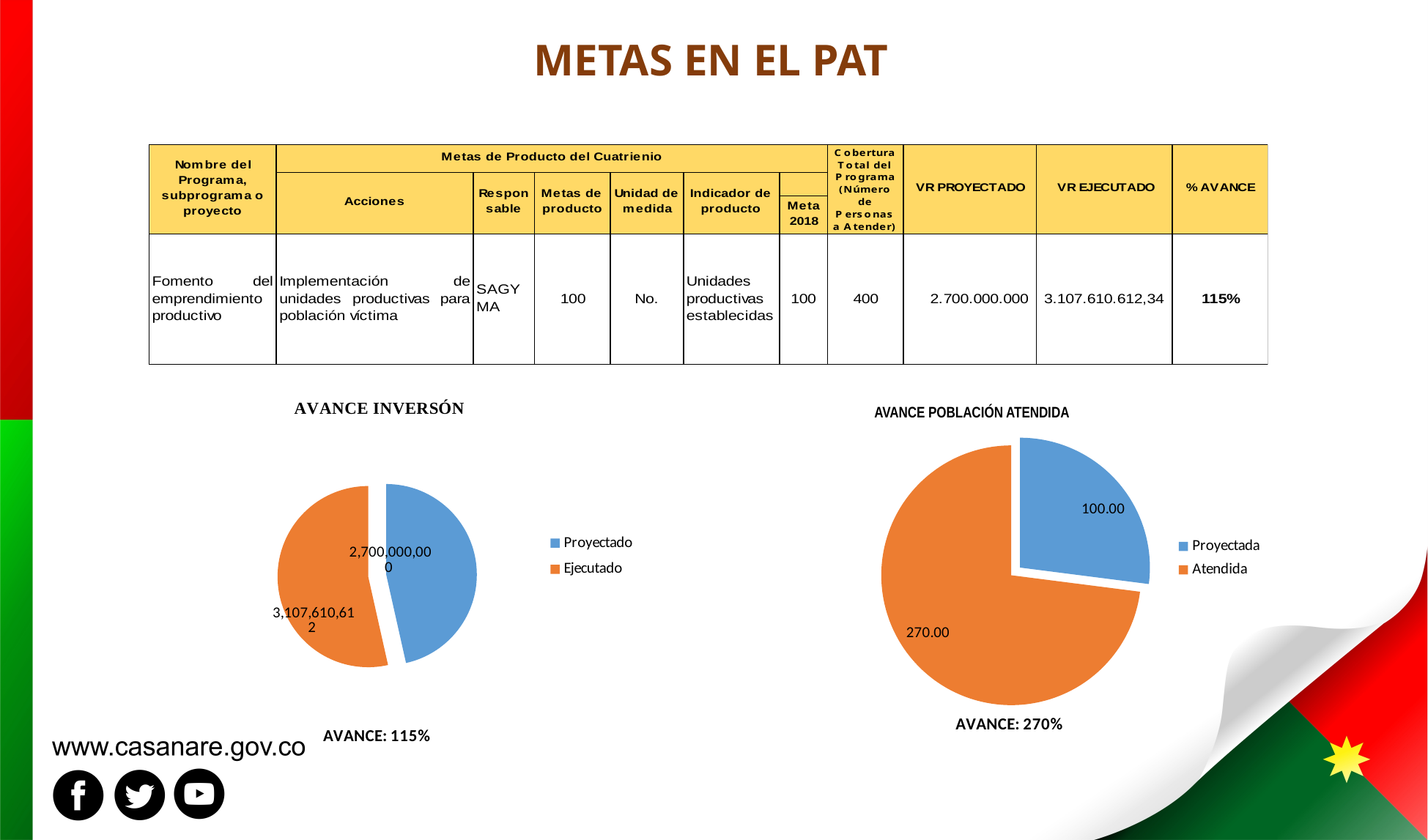
What type of chart is the "AVANCE INVERSÓN" chart? pie chart In the "AVANCE POBLACIÓN ATENDIDA" chart, what colour is the Atendida slice? orange In the "AVANCE INVERSÓN" chart, what is the value for Proyectado? 2,700,000,000 In the "AVANCE POBLACIÓN ATENDIDA" chart, what is the value for Proyectada? 100.00 In the "AVANCE INVERSÓN" chart, which slice is larger, Proyectado or Ejecutado? Ejecutado In the "AVANCE INVERSÓN" chart, what is the difference between Ejecutado and Proyectado? 407,610,612 How many entries does the legend of the "AVANCE INVERSÓN" chart list? 2 In the "AVANCE INVERSÓN" chart, what is the value for Ejecutado? 3,107,610,612 How many slices does the "AVANCE POBLACIÓN ATENDIDA" pie chart have? 2 In the "AVANCE POBLACIÓN ATENDIDA" chart, which slice is the largest? Atendida In the "AVANCE POBLACIÓN ATENDIDA" chart, what is the value for Atendida? 270.00 In the "AVANCE POBLACIÓN ATENDIDA" chart, what is the difference between Atendida and Proyectada? 170.00